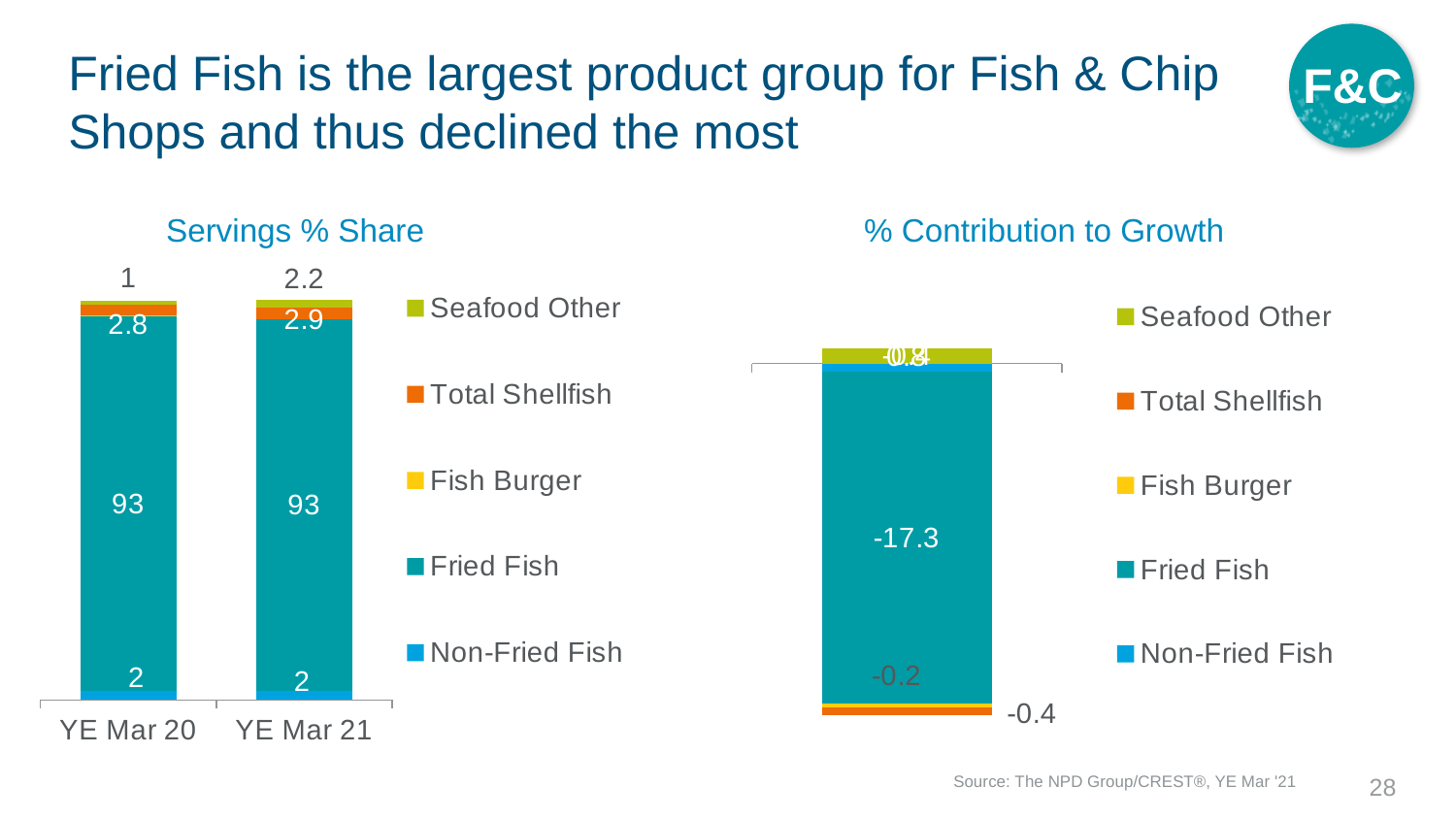
In the 'Servings % Share' chart, what is the value for Total Shellfish in YE Mar 20? 2.8 In the '% Contribution to Growth' chart, which product group has the largest negative contribution? Fried Fish How many series does the legend of the 'Servings % Share' chart list? 5 In the '% Contribution to Growth' chart, what is the value for Fried Fish? -17.3 In the 'Servings % Share' chart, which product group has the largest share in YE Mar 21? Fried Fish In the 'Servings % Share' chart, what is the value for Non-Fried Fish in YE Mar 21? 2 In the 'Servings % Share' chart, by how much did the Seafood Other value change from YE Mar 20 to YE Mar 21? 1.2 In the 'Servings % Share' chart, is the Total Shellfish value larger in YE Mar 20 or YE Mar 21? YE Mar 21 In the 'Servings % Share' chart, what is the value for Fried Fish in YE Mar 20? 93 What kind of chart is the 'Servings % Share' chart? Stacked bar chart How many time periods are shown on the x axis of the 'Servings % Share' chart? 2 In the 'Servings % Share' chart, what is the value for Seafood Other in YE Mar 21? 2.2